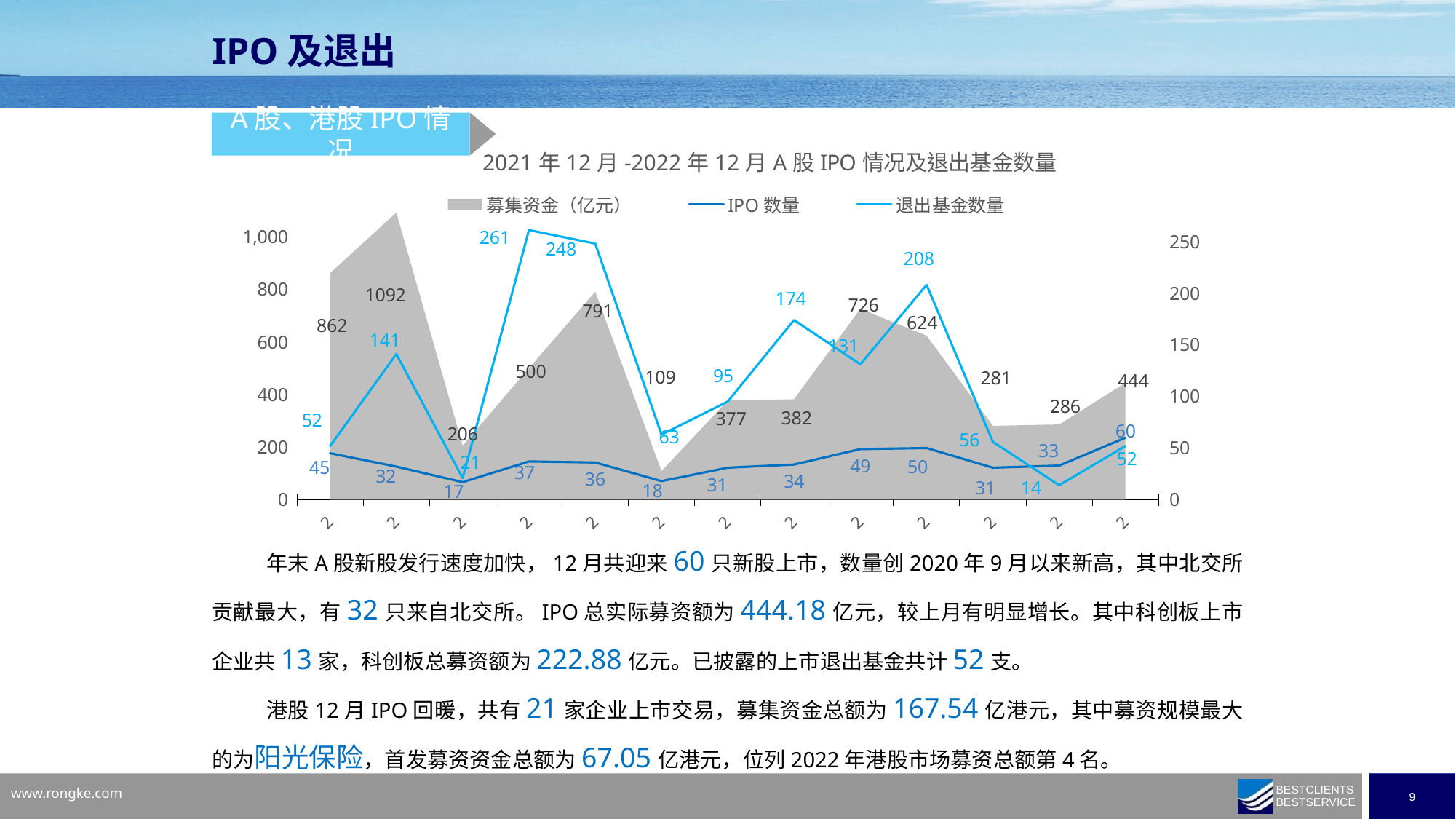
What is the highest value of 退出基金数量 shown in the chart? 261 How many series does the chart legend list? 3 What is the lowest value of 退出基金数量 shown in the chart? 14 What kind of chart is shown on the slide? A combined area and line chart What is the 募集资金（亿元） value at the rightmost (last) data point of the chart? 444 What is the highest value of IPO 数量 shown in the chart? 60 What is the title of the chart? 2021 年 12 月 -2022 年 12 月 A 股 IPO 情况及退出基金数量 What is the lowest value of IPO 数量 shown in the chart? 17 How many data points does each series in the chart have? 13 What is the lowest value of 募集资金（亿元） shown in the chart? 109 What is the difference between the highest and lowest 募集资金（亿元） values in the chart? 983 What is the highest value of 募集资金（亿元） shown in the chart? 1092